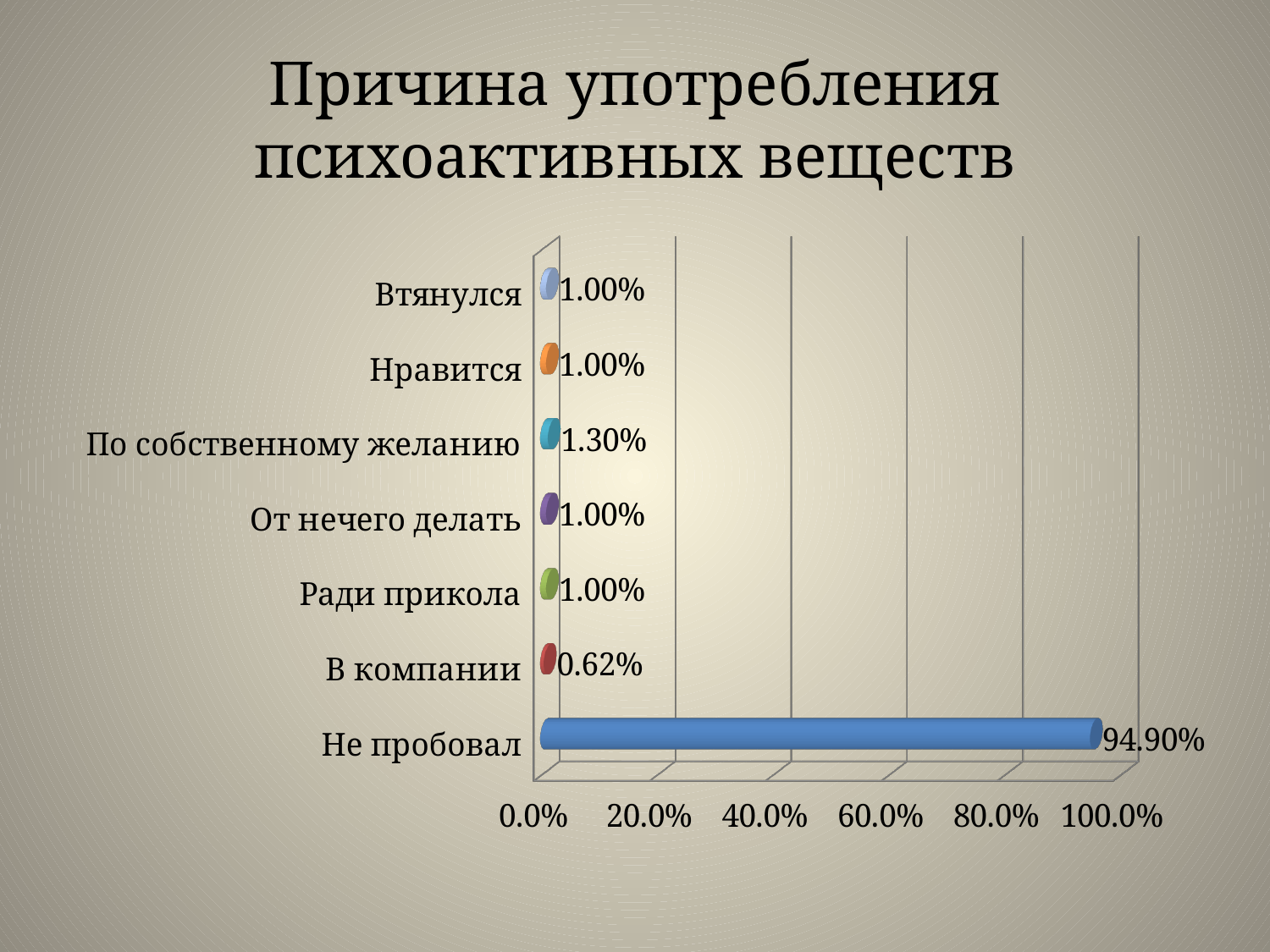
What is the difference between the values for "Не пробовал" and "По собственному желанию"? 93.60% What is the value for "По собственному желанию"? 1.30% What is the value for "Ради прикола"? 1.00% Which category has the lowest value? В компании Is the value for "Не пробовал" greater or less than 80.0%? greater What is the value for "В компании"? 0.62% What type of chart is shown on the slide? Bar chart How many categories are shown in the chart? 7 What is the value for "Не пробовал"? 94.90% Which is larger, the value for "По собственному желанию" or the value for "В компании"? По собственному желанию What is the difference between the values for "По собственному желанию" and "В компании"? 0.68% Which category has the highest value? Не пробовал